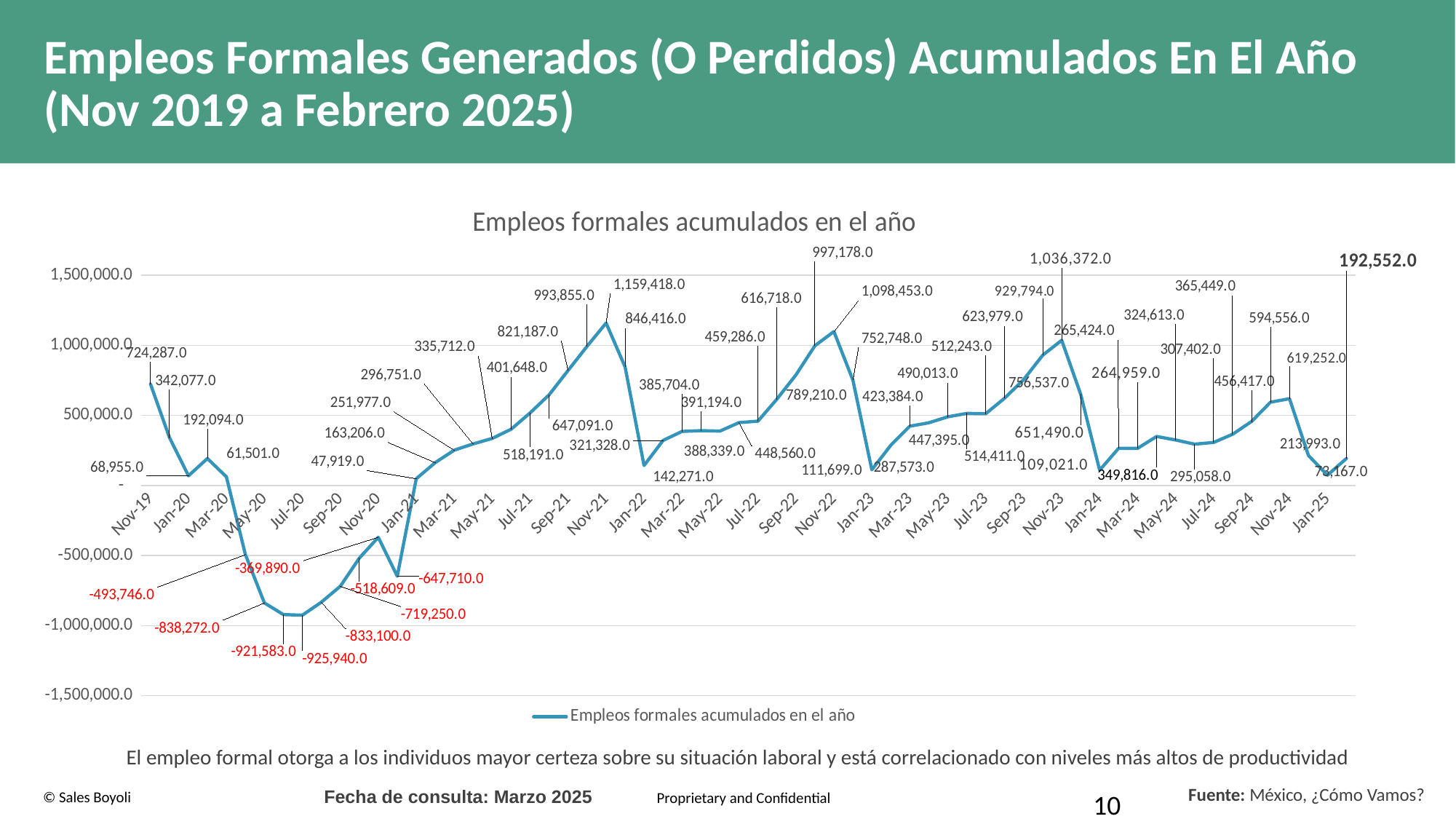
What is the value for Nov-19? 724,287.0 What is the title of the chart? Empleos formales acumulados en el año Which is larger, the value in Nov-21 or the value in Nov-23? Nov-21 What type of chart is shown on the slide? line chart What is the value of the last data point on the chart (shown in bold)? 192,552.0 What is the lowest value plotted on the chart? -925,940.0 How many series does the chart legend list? 1 In which month does the line reach its highest value? Nov-21 Is the value for Jul-20 greater or less than -500,000.0? less Does the line rise or fall between Jan-21 and Nov-21? rise What is the difference between the peak in Nov-21 (1,159,418.0) and the peak in Nov-22 (1,098,453.0)? 60,965.0 What is the highest value plotted on the chart? 1,159,418.0